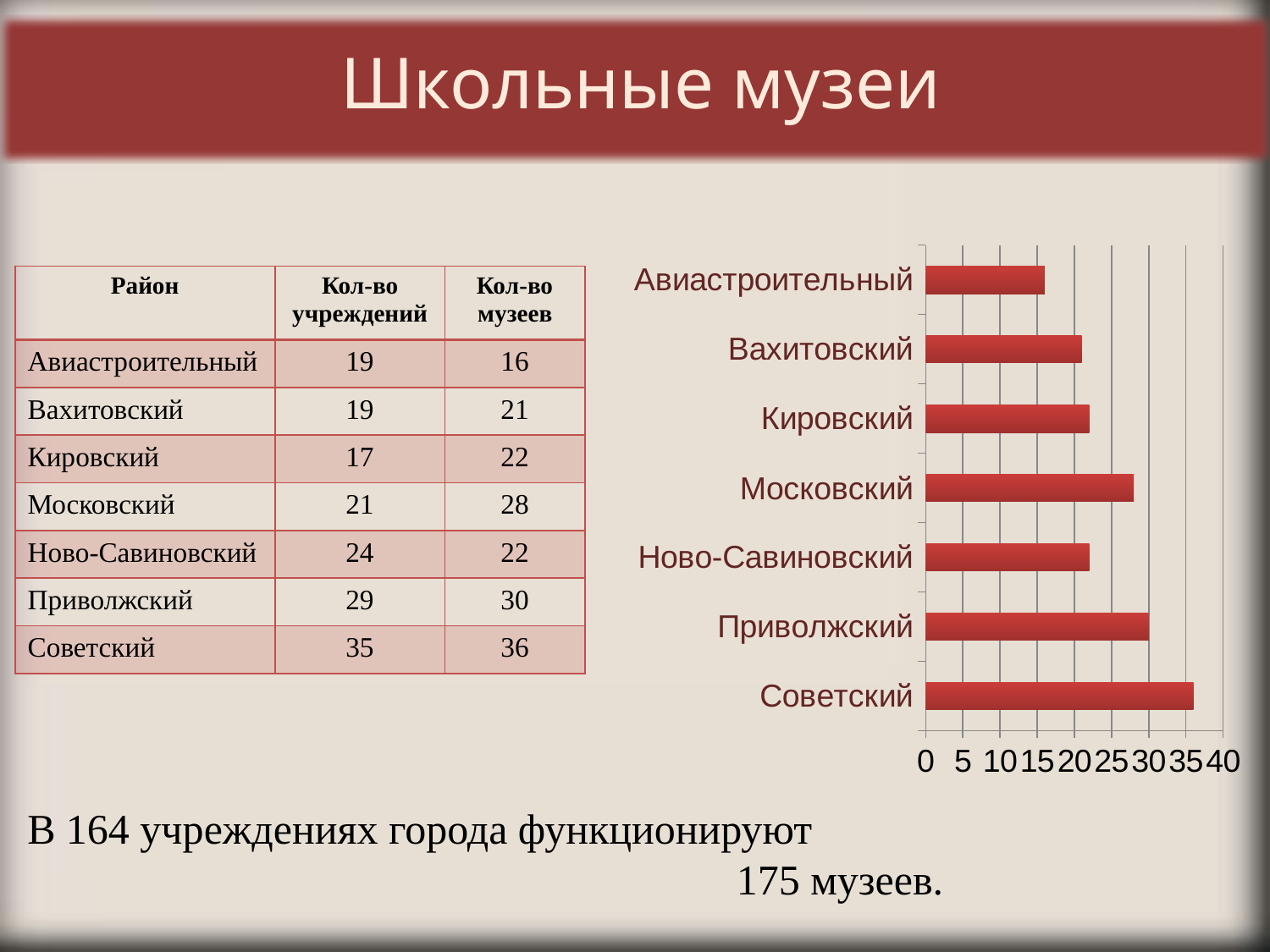
According to the table on the slide, how many museums (Кол-во музеев) does Советский have, matching its bar in the chart? 36 Is the bar for Вахитовский greater or less than 25? less What is the highest value shown on the chart's horizontal axis? 40 What kind of chart is shown on the slide? bar chart Which district has the shortest bar in the chart? Авиастроительный Which district has the longest bar in the chart? Советский Which bar is longer, Советский or Приволжский? Советский Which bar is longer, Московский or Вахитовский? Московский Is the bar for Московский greater or less than 25? greater Is the bar for Советский greater or less than 30? greater How many districts (categories) are plotted in the bar chart? 7